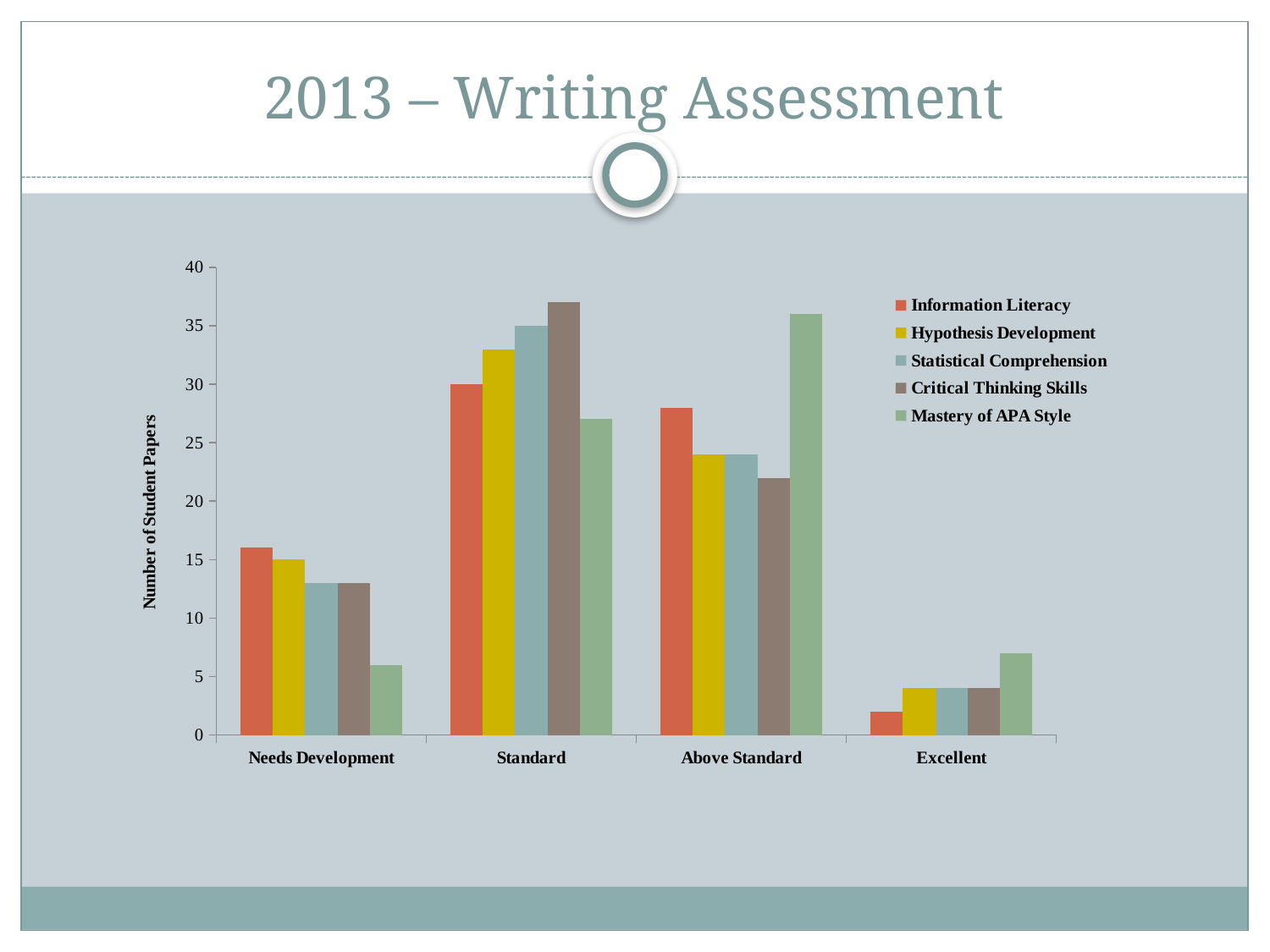
What is the value for Hypothesis Development in the Needs Development category? 15 Is the value for Critical Thinking Skills in the Standard category greater or less than 35? greater In the Needs Development category, which is larger: Information Literacy or Mastery of APA Style? Information Literacy Which series has the lowest value in the Needs Development category? Mastery of APA Style What is the label of the vertical axis? Number of Student Papers What is the value for Information Literacy in the Standard category? 30 Is the value for Critical Thinking Skills in the Above Standard category greater or less than 25? less Which series has the highest value in the Above Standard category? Mastery of APA Style What kind of chart is shown on the slide? bar chart Which series has the highest value in the Standard category? Critical Thinking Skills How many categories are shown on the x axis? 4 How many series does the legend list? 5